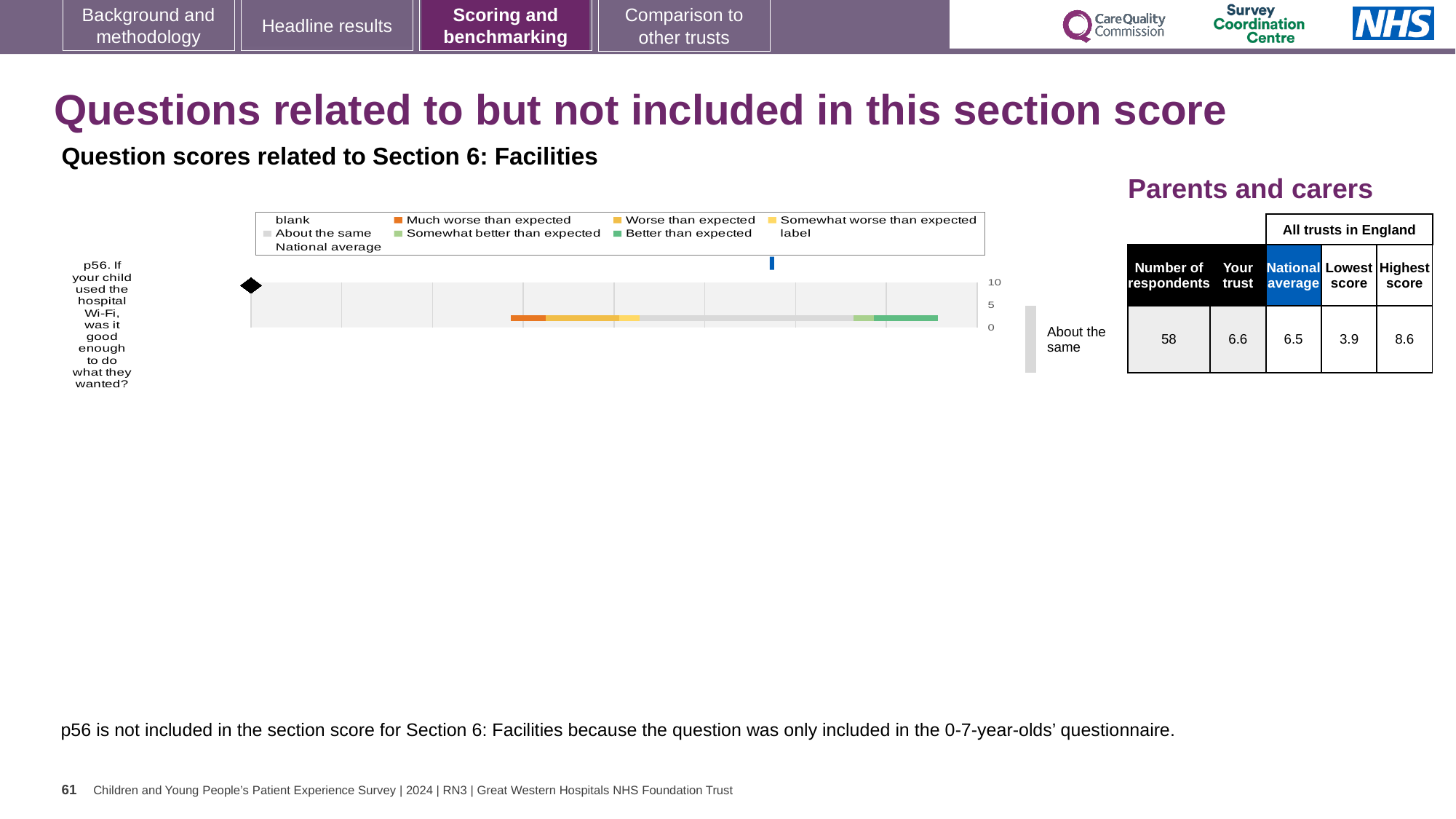
What benchmark category is shown for the trust's result on p56? About the same In the table beside the chart, what is the 'Your trust' score for p56? 6.6 In the table beside the chart, what is the National average score for p56? 6.5 In the table beside the chart, what is the Lowest score among all trusts in England for p56? 3.9 Which respondent group does the chart on this slide relate to? Parents and carers What is the difference between the 'Your trust' score and the National average for p56? 0.1 What kind of chart is shown for question p56? Bar chart Which is larger for p56, the 'Your trust' score or the National average? Your trust How many respondents answered question p56? 58 How many survey questions are plotted in the chart? 1 In the table beside the chart, what is the Highest score among all trusts in England for p56? 8.6 What is the difference between the Highest score and the Lowest score for p56? 4.7